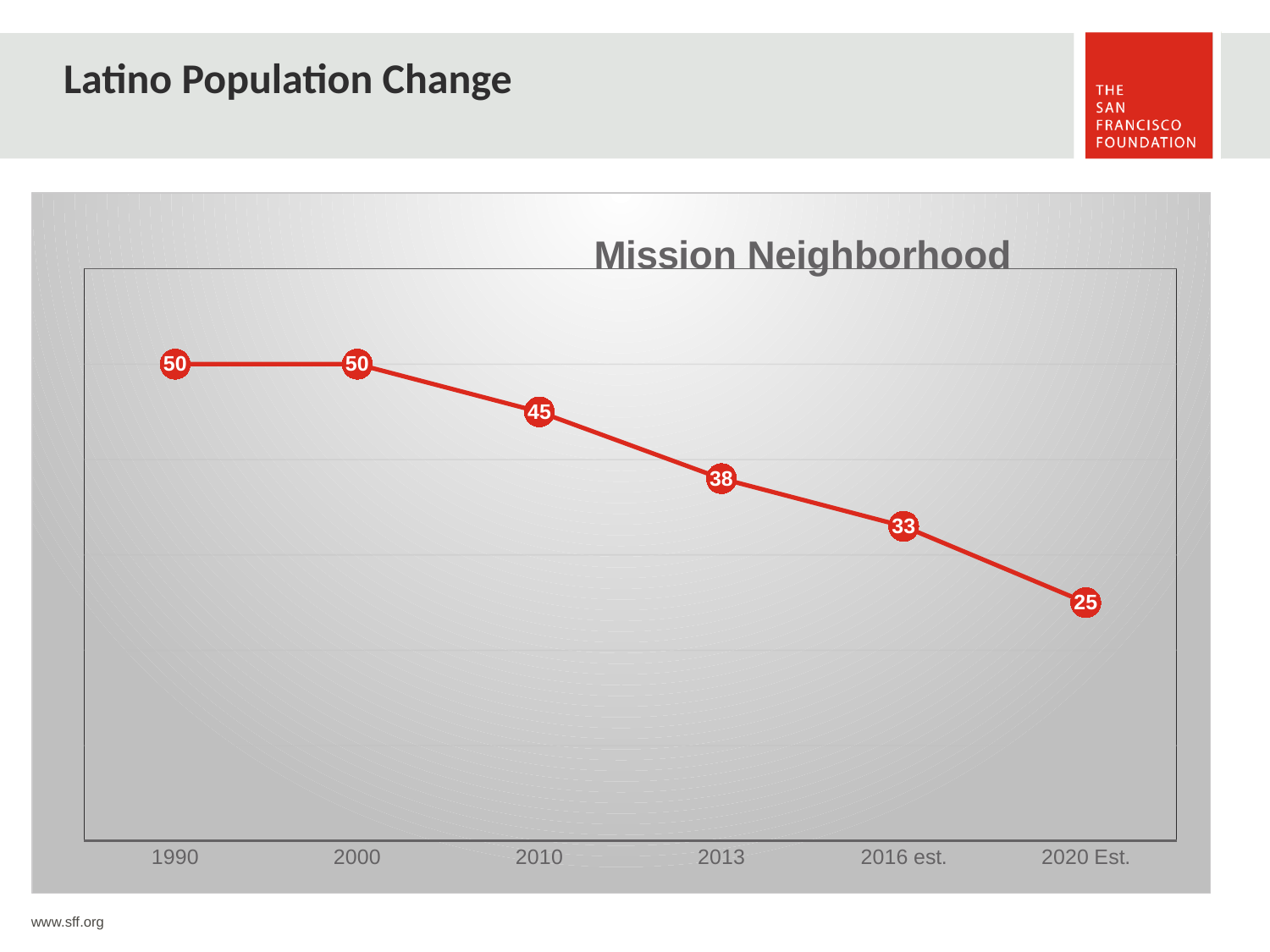
Do the values rise or fall from 2000 to 2020 Est.? fall What kind of chart is shown? line chart What is the difference between the values for 2000 and 2020 Est.? 25 What is the value for 1990? 50 What is the value for 2020 Est.? 25 What is the value for 2016 est.? 33 How many data points are plotted on the chart? 6 What is the value for 2010? 45 Which x-axis category has the lowest value? 2020 Est. What is the difference between the values for 2010 and 2013? 7 What is the value for 2013? 38 Which is larger, the value for 2013 or the value for 2016 est.? 2013